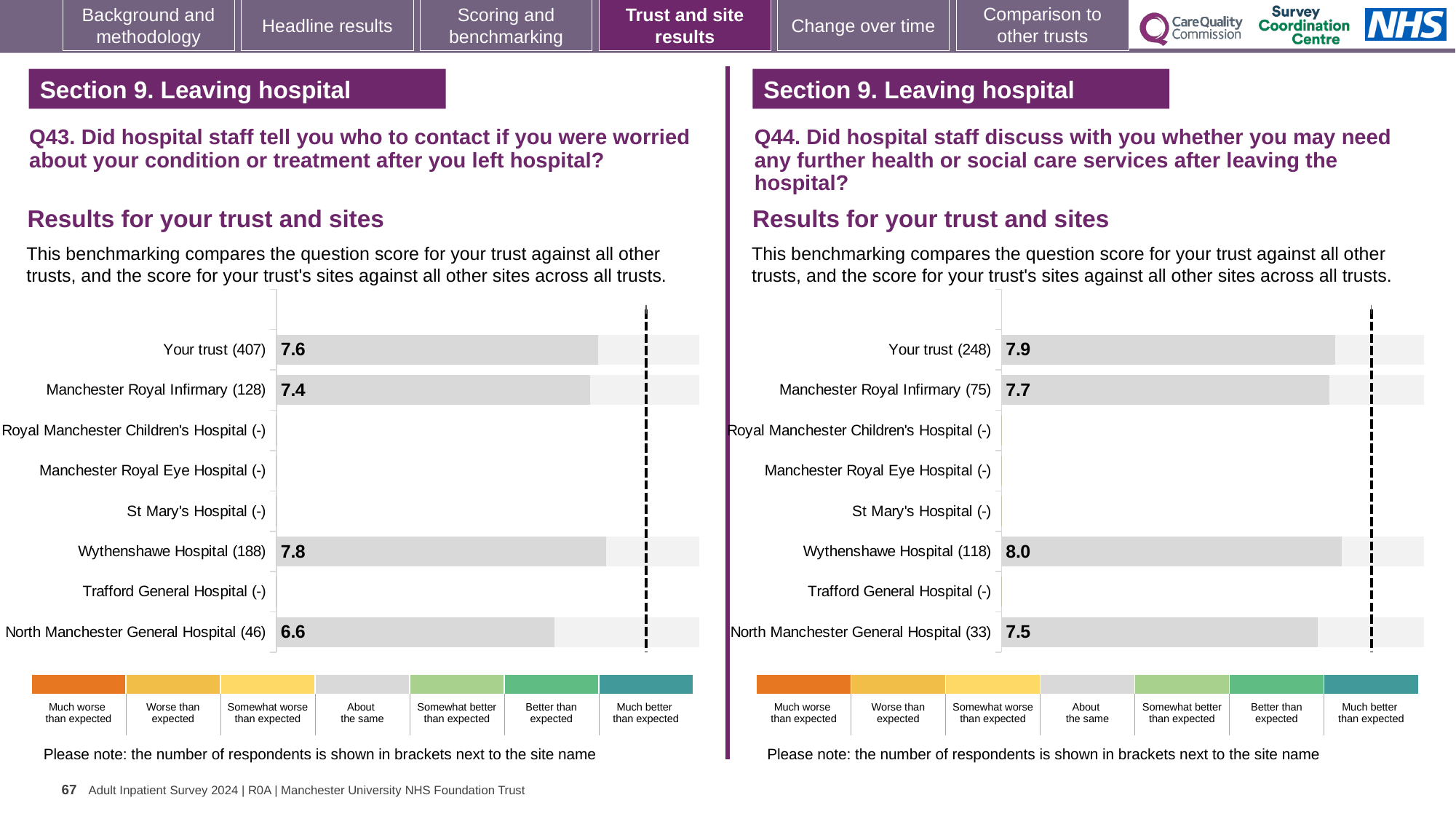
In the Q44 chart on the right, which is larger, the score for Your trust or the score for North Manchester General Hospital? Your trust In the Q43 chart on the left, what is the difference between the scores for Wythenshawe Hospital and North Manchester General Hospital? 1.2 In the Q43 chart on the left, which site has the highest score? Wythenshawe Hospital In the Q44 chart on the right, what is the score for Wythenshawe Hospital? 8.0 In the Q44 chart on the right, what is the score for Manchester Royal Infirmary? 7.7 How many site or trust labels are listed on the y axis of the Q44 chart on the right? 8 What kind of chart is used for the Q43 results on the left? Bar chart In the Q43 chart on the left, how many respondents are shown for Manchester Royal Infirmary? 128 In the Q44 chart on the right, what is the difference between the scores for Your trust and Manchester Royal Infirmary? 0.2 In the Q43 chart on the left, what is the score for Your trust? 7.6 In the Q43 chart on the left, which site has the lowest score? North Manchester General Hospital In the Q43 chart on the left, what is the score for North Manchester General Hospital? 6.6